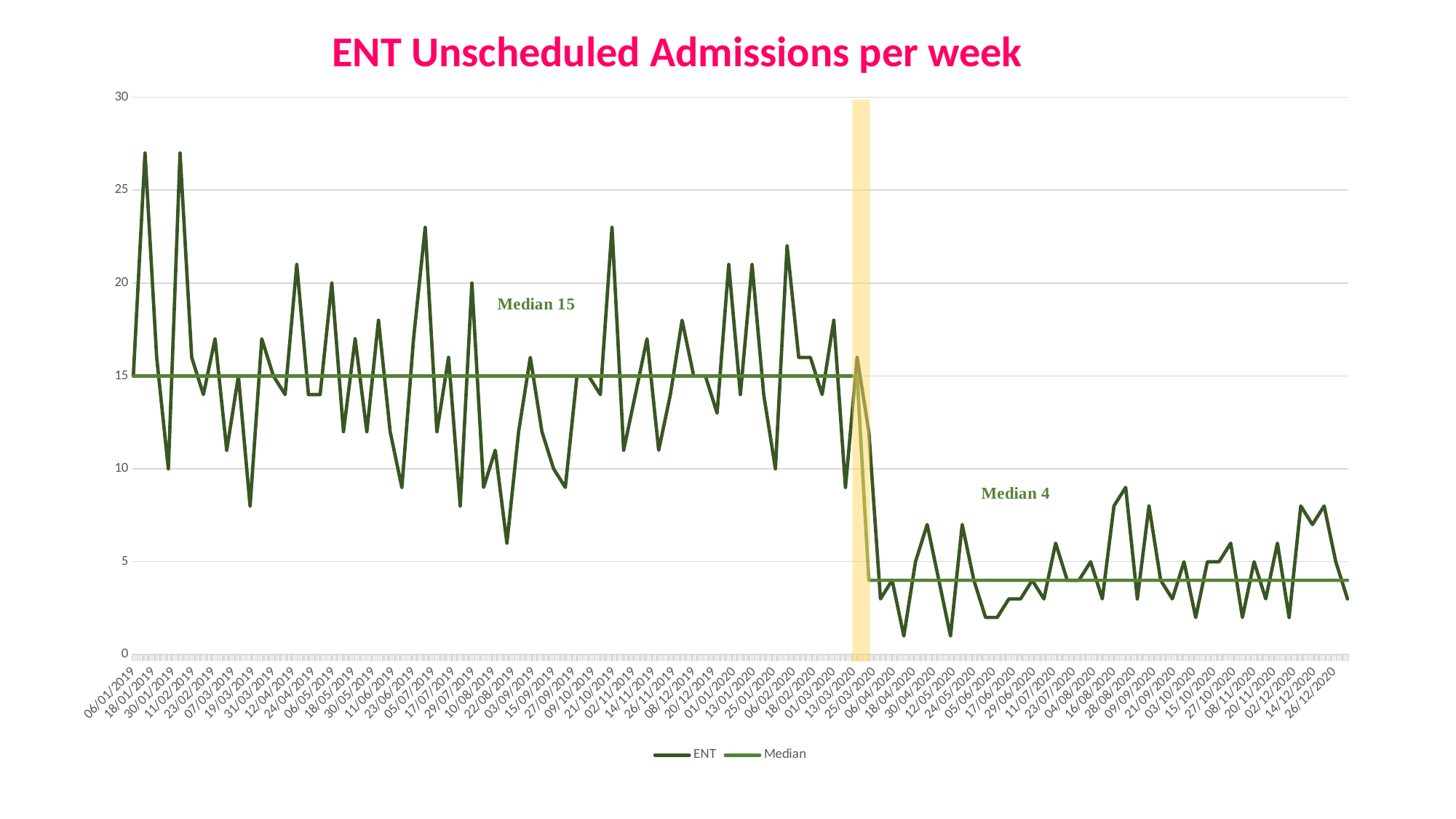
What is the title of the chart? ENT Unscheduled Admissions per week What kind of chart is shown on the slide? Line chart Which period has the higher median, the period before the shaded band or the period after it? The period before the shaded band What median value is annotated for the period after the shaded band? Median 4 By how much does the median fall from the earlier period (Median 15) to the later period (Median 4)? 11 Overall, do the ENT weekly admissions rise or fall from 2019 to the end of 2020? Fall What median value is annotated for the period before the shaded band? Median 15 What are the two series named in the legend? ENT and Median How many series does the legend list? 2